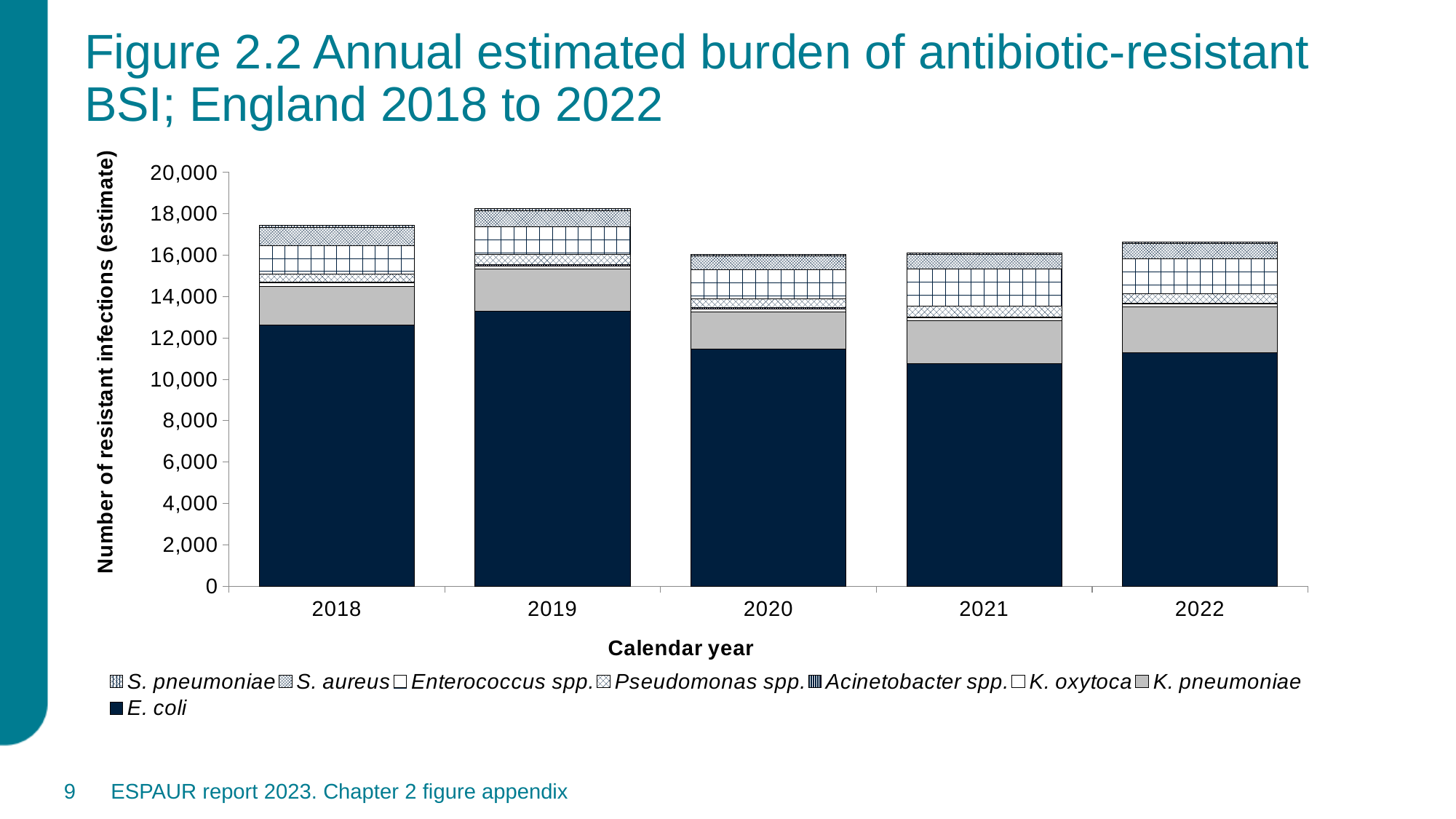
Which year has the smallest E. coli segment? 2021 How many calendar years are shown on the x axis? 5 What kind of chart is shown on the slide? Stacked bar chart Which is larger, the E. coli segment for 2019 or for 2021? 2019 Which year has the highest total number of resistant infections? 2019 Is the E. coli value for 2020 greater or less than 12,000? less What is the title of the y axis? Number of resistant infections (estimate) Is the E. coli value for 2019 greater or less than 12,000? greater Is the total stacked bar for 2018 greater or less than 16,000? greater Which year has the largest E. coli segment? 2019 How many series does the legend list? 8